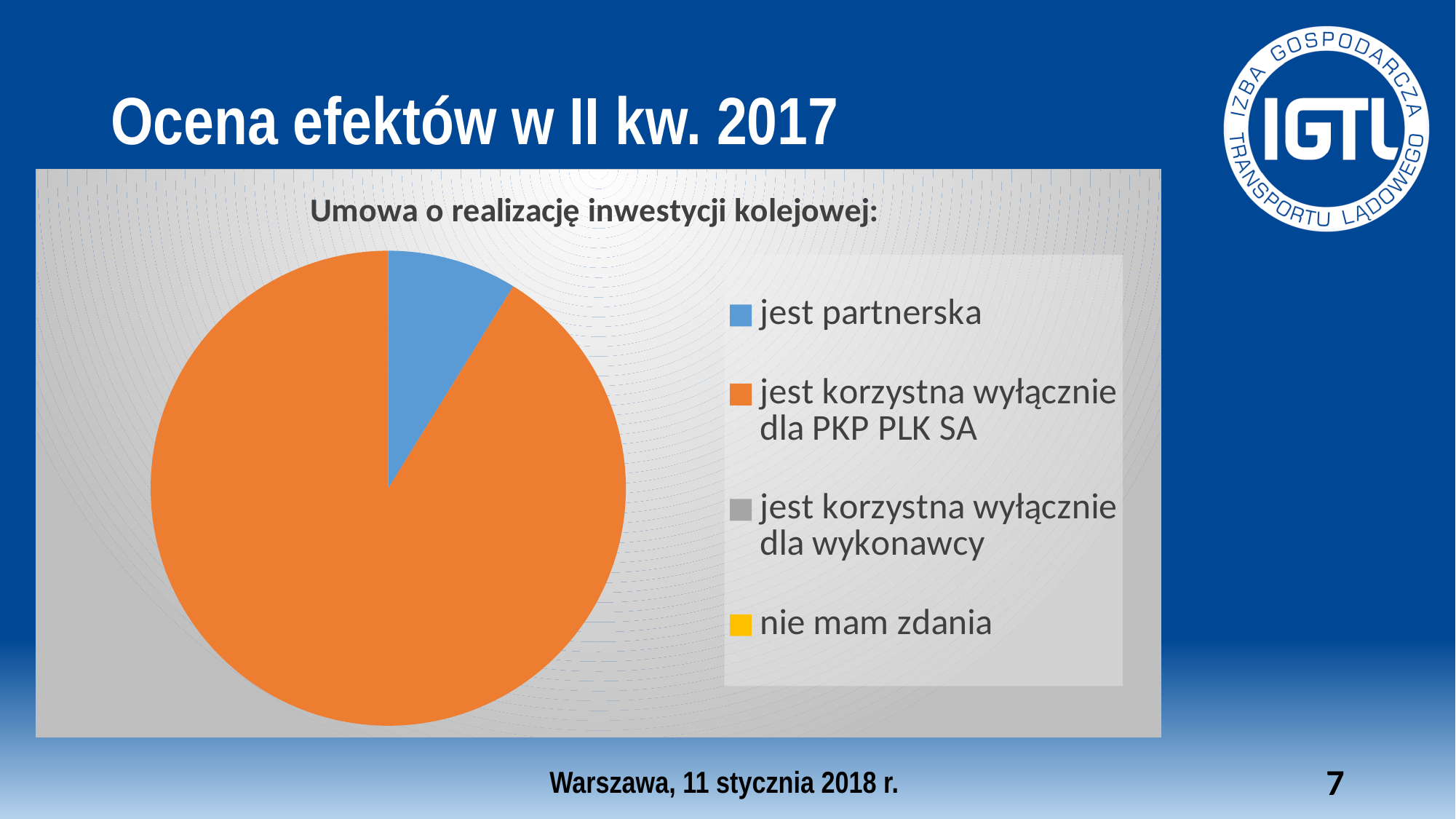
What is the title of the chart? Umowa o realizację inwestycji kolejowej: Does the slice for 'jest korzystna wyłącznie dla PKP PLK SA' take up more or less than half of the pie? more How many entries does the chart legend list? 4 How many slices are visible in the pie? 2 Which is larger: the slice for 'jest partnerska' or the slice for 'jest korzystna wyłącznie dla PKP PLK SA'? jest korzystna wyłącznie dla PKP PLK SA What colour is the slice for 'jest partnerska'? blue Which of the visible slices is the smallest? jest partnerska What kind of chart is shown on the slide? pie chart Which category has the largest slice of the pie? jest korzystna wyłącznie dla PKP PLK SA